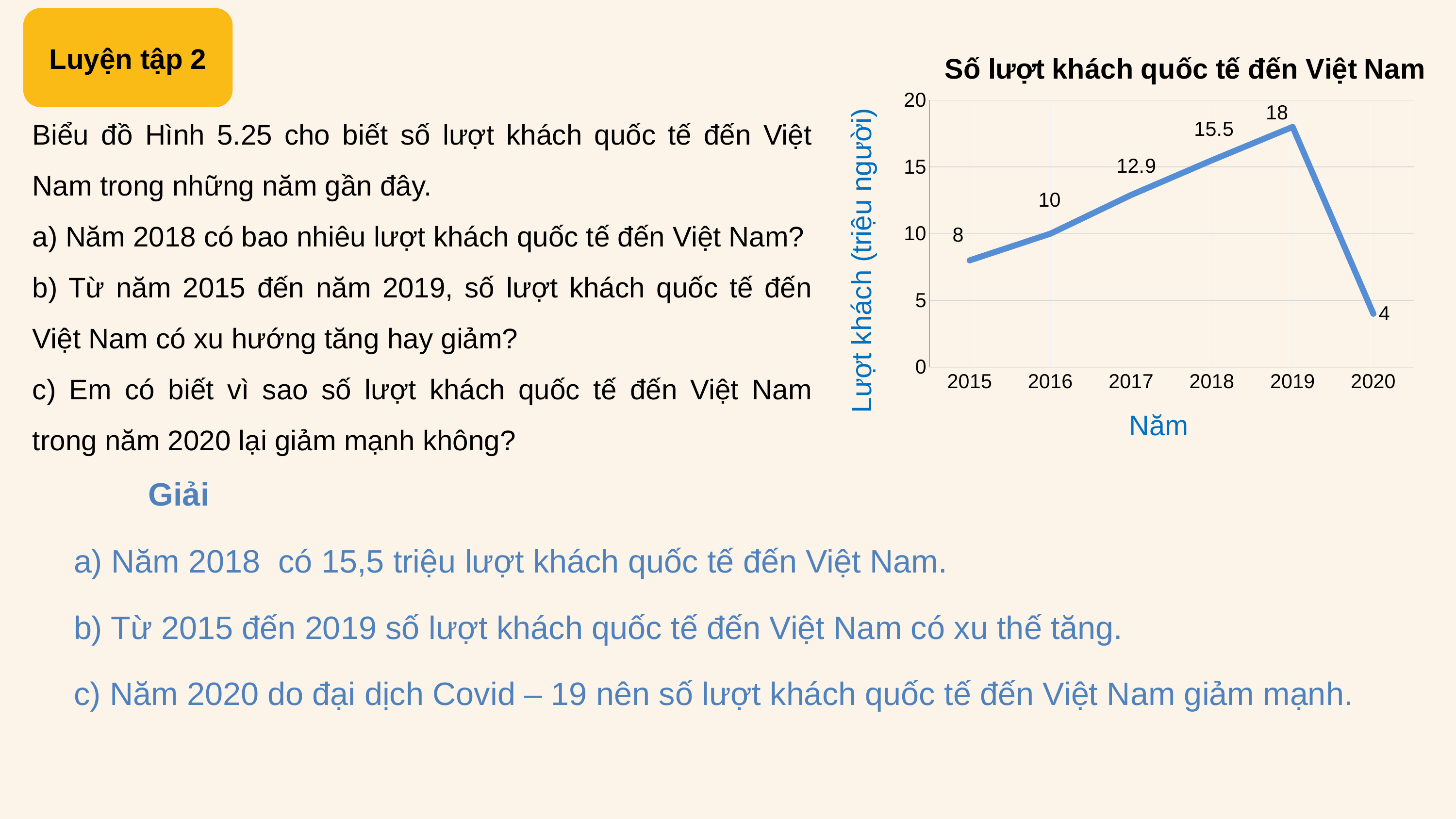
Which year has the highest value in the chart? 2019 Which is larger, the value for 2017 or the value for 2016? 2017 What is the value for 2020 in the chart? 4 What is the title of the chart? Số lượt khách quốc tế đến Việt Nam What is the value for 2018 in the chart? 15.5 What is the difference between the values for 2019 and 2020? 14 What is the difference between the values for 2017 and 2015? 4.9 What kind of chart is shown on the slide? line chart Which year has the lowest value in the chart? 2020 How many years are plotted in the chart? 6 Do the values rise or fall from 2015 to 2019? rise What is the value for 2016 in the chart? 10